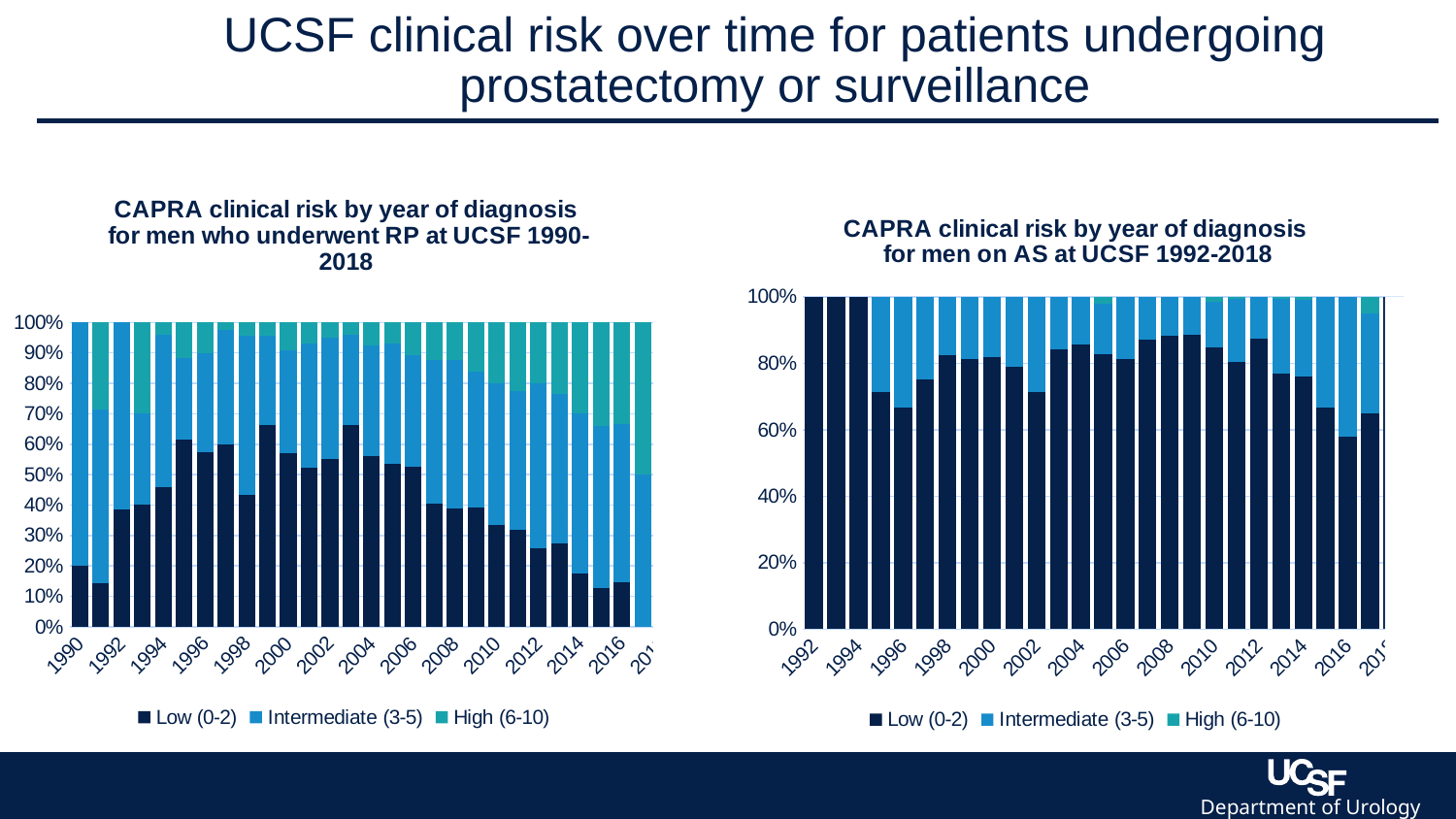
In the left chart (men who underwent RP), does the Low (0-2) share generally rise or fall from 1999 to 2016? fall What kind of chart is the left chart, 'CAPRA clinical risk by year of diagnosis for men who underwent RP at UCSF 1990-2018'? Stacked bar chart How many series does the legend of the right chart, 'CAPRA clinical risk by year of diagnosis for men on AS at UCSF 1992-2018', list? 3 What is the title of the right chart? CAPRA clinical risk by year of diagnosis for men on AS at UCSF 1992-2018 In the right chart (men on AS), which year has a larger Low (0-2) share, 1992 or 1996? 1992 In the left chart (men who underwent RP), is the Low (0-2) share for 1999 greater or less than 60%? greater In the right chart (men on AS), is the Low (0-2) share for 1996 greater or less than 60%? greater In the left chart (men who underwent RP), is the Low (0-2) share for 2010 greater or less than 40%? less In the left chart (men who underwent RP), which year has a larger Low (0-2) share, 1999 or 2015? 1999 In the right chart (men on AS), what is the Low (0-2) share for 1992? 100% What are the three legend entries on the left chart? Low (0-2), Intermediate (3-5), High (6-10)